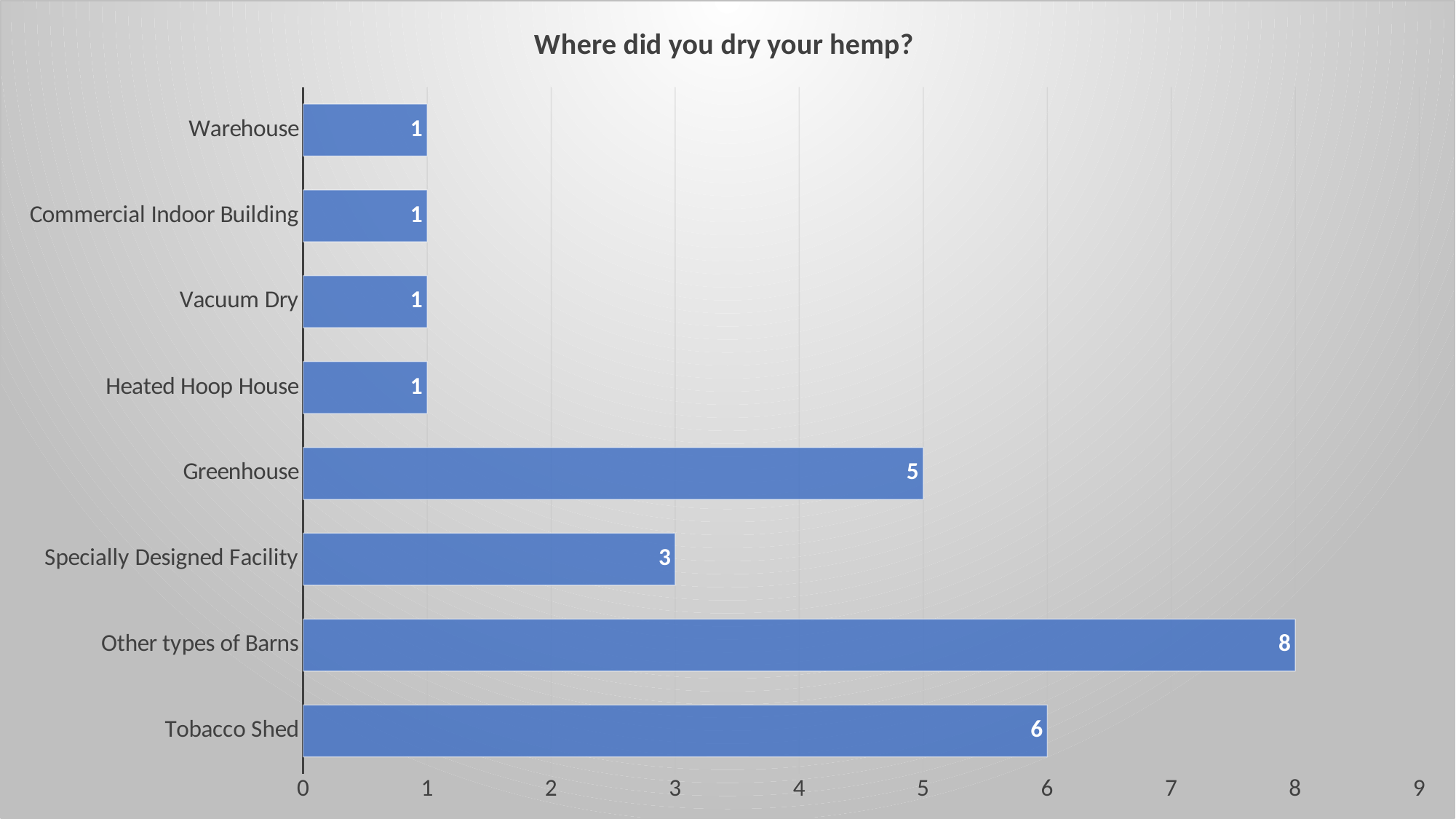
Is the value for Other types of Barns greater or less than 7? greater Which category has the highest value? Other types of Barns What is the difference between the values for Other types of Barns and Tobacco Shed? 2 What is the title of the chart? Where did you dry your hemp? What is the difference between the values for Greenhouse and Specially Designed Facility? 2 What is the value for Greenhouse? 5 How many categories have a value of 1? 4 How many categories are shown in the chart? 8 What is the value for Specially Designed Facility? 3 Which is larger, the value for Greenhouse or the value for Tobacco Shed? Tobacco Shed What kind of chart is shown on the slide? bar chart What is the value for Tobacco Shed? 6